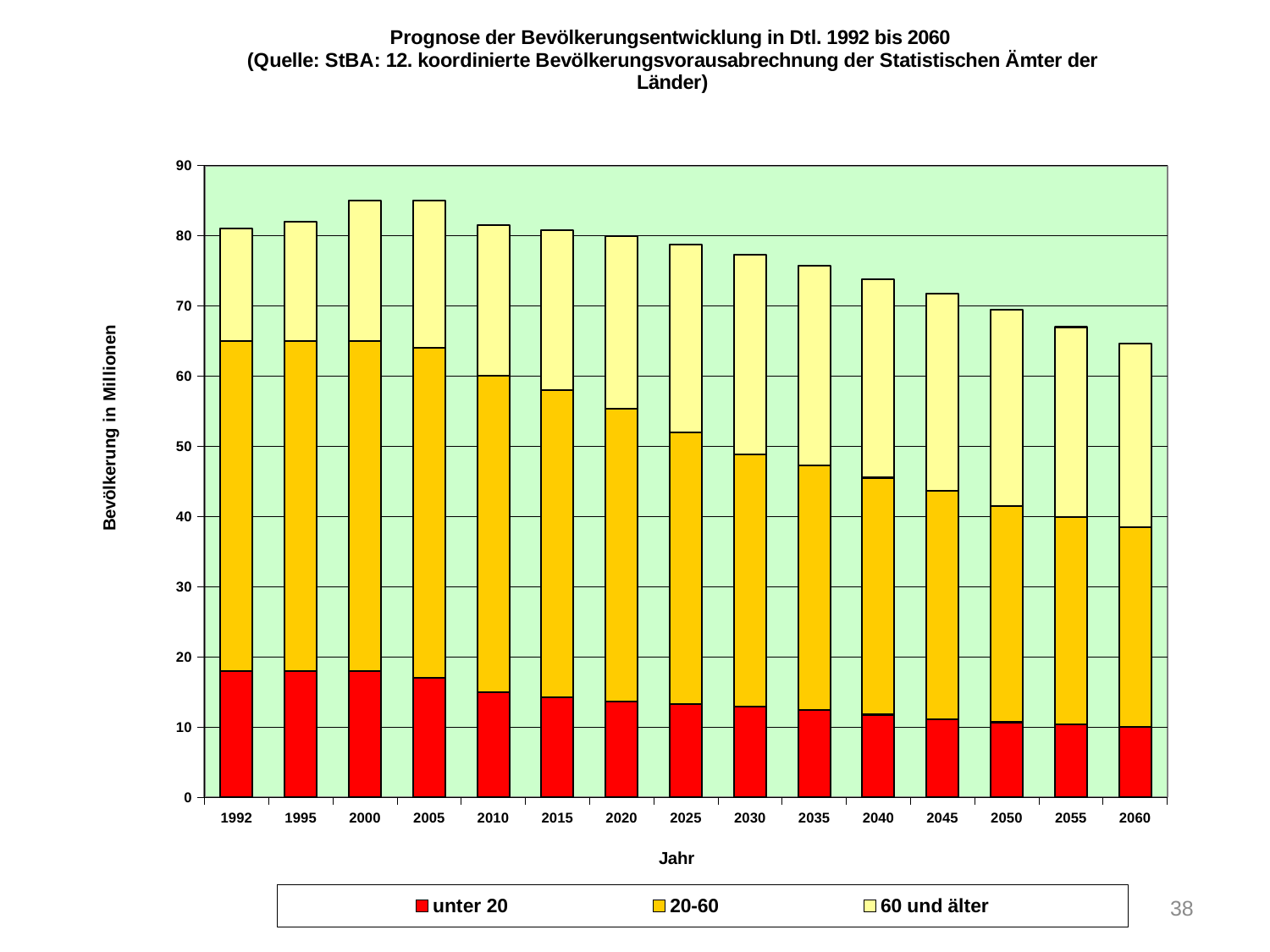
Is the total population for 2000 greater or less than 80 million? greater Is the value for 'unter 20' in 2040 greater or less than 10 million? greater What kind of chart is shown on the slide? Stacked bar chart What is the label of the y axis? Bevölkerung in Millionen Which year has the lowest total population in the chart? 2060 Which series is shown in red? unter 20 Which is larger, the total population in 1992 or in 2060? 1992 From 2010 to 2060, does the total population rise or fall? fall Is the total population for 2060 greater or less than 70 million? less How many series does the legend list? 3 How many years are shown on the x axis of the chart? 15